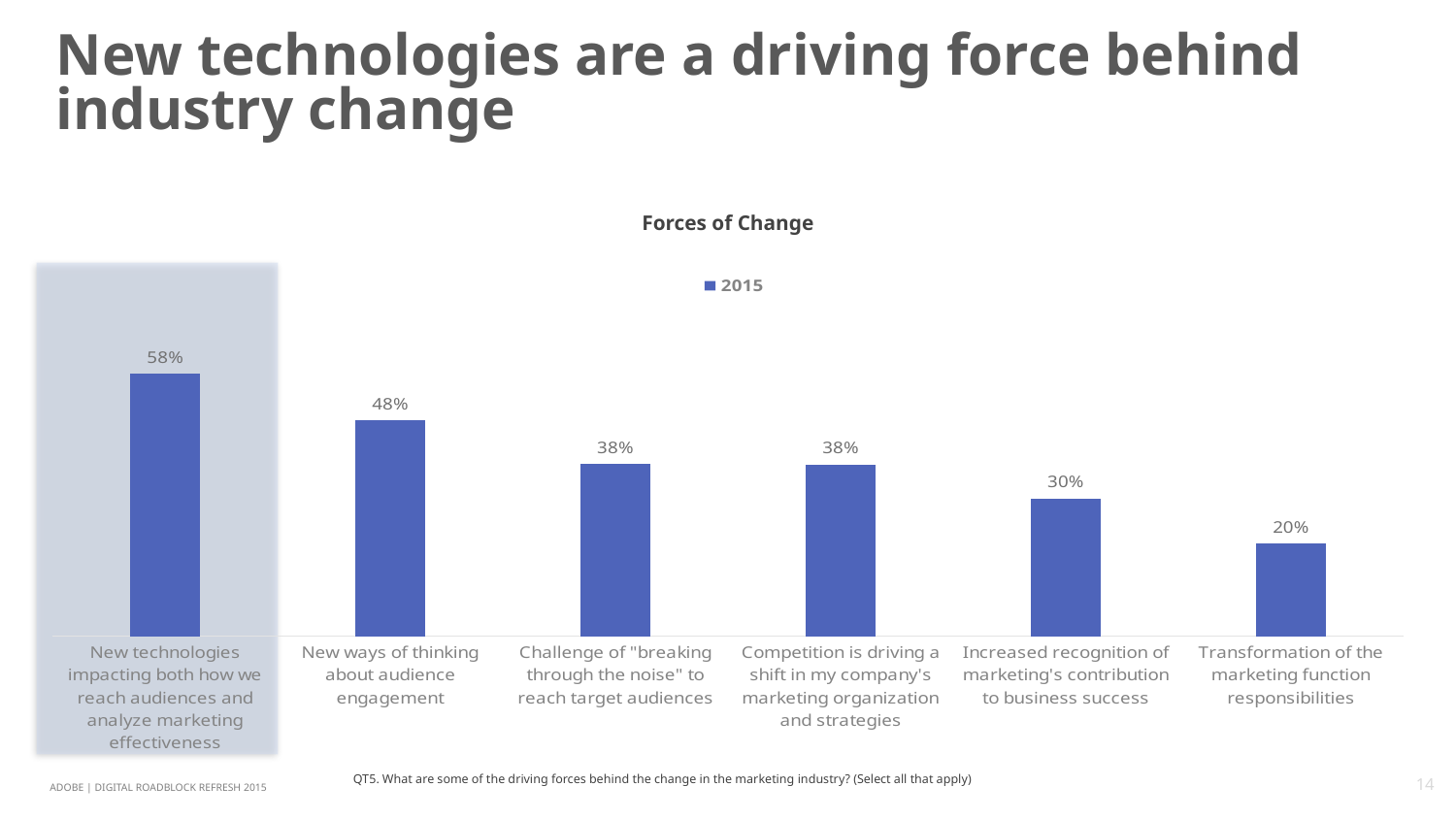
What is the value for "New technologies impacting both how we reach audiences and analyze marketing effectiveness"? 58% What is the difference between the values for "New technologies impacting both how we reach audiences and analyze marketing effectiveness" and "New ways of thinking about audience engagement"? 10% How many categories are shown in the chart? 6 What is the value for "Transformation of the marketing function responsibilities"? 20% Which category has the highest value? New technologies impacting both how we reach audiences and analyze marketing effectiveness What is the title of the chart? Forces of Change What is the value for "Increased recognition of marketing's contribution to business success"? 30% What series name is shown in the chart legend? 2015 What kind of chart is shown on the slide? Bar chart Which is larger: the value for "New ways of thinking about audience engagement" or the value for "Increased recognition of marketing's contribution to business success"? New ways of thinking about audience engagement How many series does the legend list? 1 Which category has the lowest value? Transformation of the marketing function responsibilities